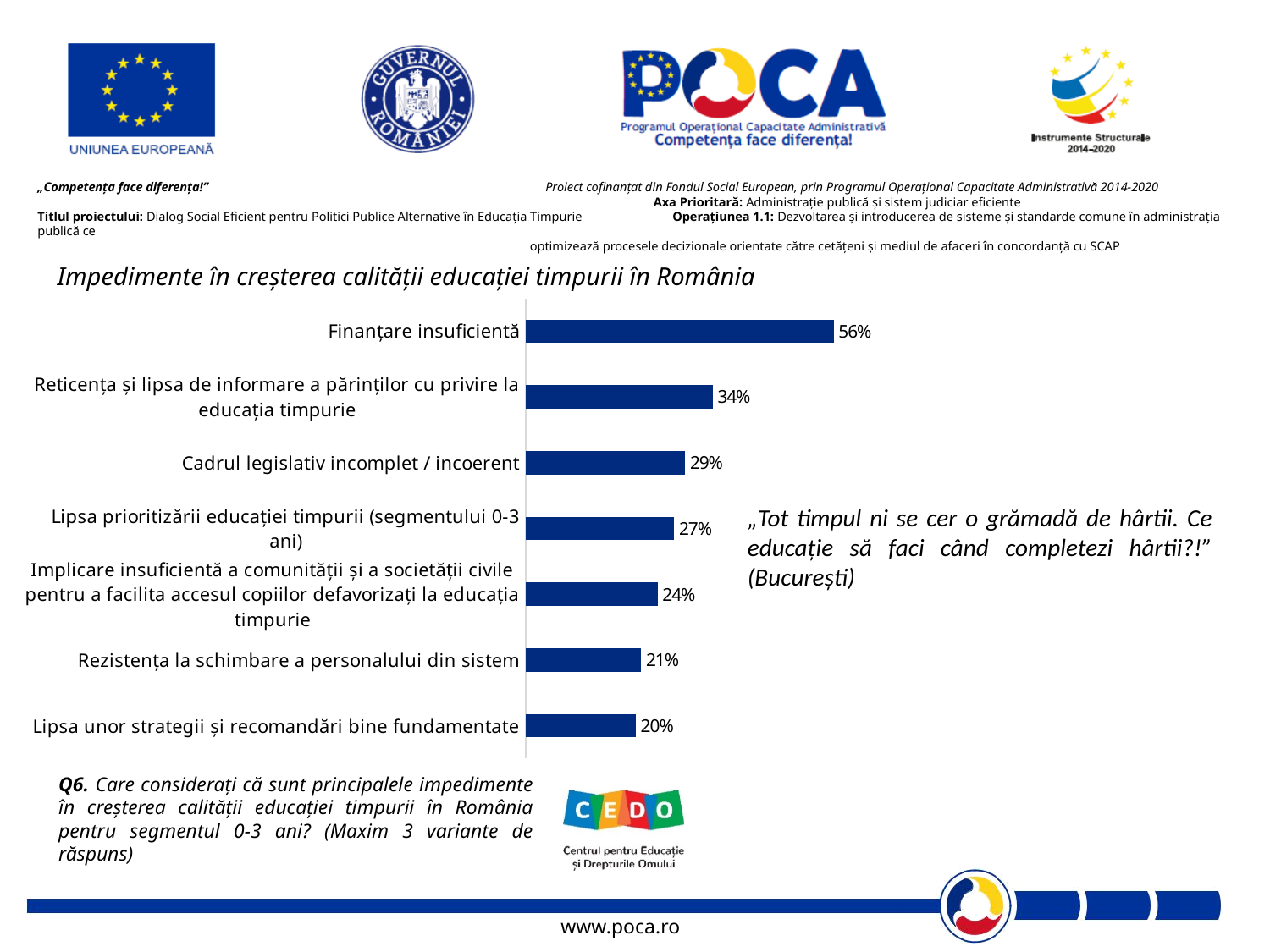
What is the title of the chart? Impedimente în creșterea calității educației timpurii în România Which category has the highest value in the chart? Finanțare insuficientă What kind of chart is shown on the slide? Bar chart What percentage is shown for "Finanțare insuficientă"? 56% Which category has the lowest value in the chart? Lipsa unor strategii și recomandări bine fundamentate How many categories are shown in the chart? 7 What percentage is shown for "Rezistența la schimbare a personalului din sistem"? 21% What is the difference between the values for "Rezistența la schimbare a personalului din sistem" and "Lipsa unor strategii și recomandări bine fundamentate"? 1% Which is larger: the value for "Cadrul legislativ incomplet / incoerent" or the value for "Lipsa prioritizării educației timpurii (segmentului 0-3 ani)"? Cadrul legislativ incomplet / incoerent What is the difference between the values for "Finanțare insuficientă" and "Reticența și lipsa de informare a părinților cu privire la educația timpurie"? 22% What is the value for "Implicare insuficientă a comunității și a societății civile pentru a facilita accesul copiilor defavorizați la educația timpurie"? 24% What value is shown for "Cadrul legislativ incomplet / incoerent"? 29%